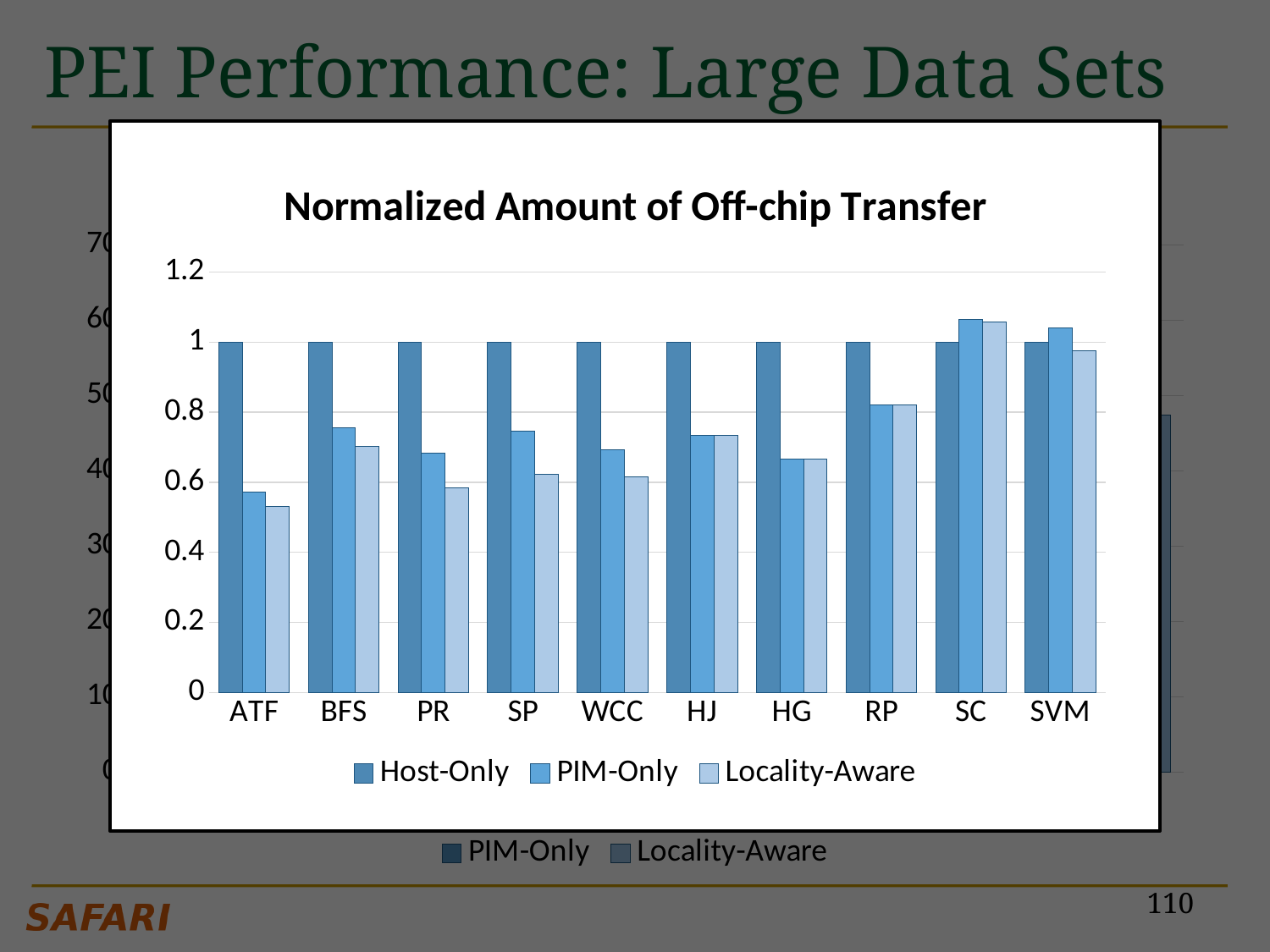
In the 'Normalized Amount of Off-chip Transfer' chart, is the Locality-Aware value for ATF greater or less than 0.6? less How many categories are shown on the x axis of the 'Normalized Amount of Off-chip Transfer' chart? 10 What are the three legend entries of the 'Normalized Amount of Off-chip Transfer' chart? Host-Only, PIM-Only, Locality-Aware In the 'Normalized Amount of Off-chip Transfer' chart, for ATF, which is larger: the PIM-Only value or the Locality-Aware value? PIM-Only In the 'Normalized Amount of Off-chip Transfer' chart, which category has the lowest PIM-Only value? ATF In the 'Normalized Amount of Off-chip Transfer' chart, what is the Host-Only value for ATF? 1 In the 'Normalized Amount of Off-chip Transfer' chart, for SVM, which is larger: the PIM-Only value or the Locality-Aware value? PIM-Only In the 'Normalized Amount of Off-chip Transfer' chart, is the PIM-Only value for HG greater or less than 0.6? greater In the 'Normalized Amount of Off-chip Transfer' chart, is the PIM-Only value for BFS greater or less than 0.8? less What type of chart is 'Normalized Amount of Off-chip Transfer'? bar chart How many series does the legend of the 'Normalized Amount of Off-chip Transfer' chart list? 3